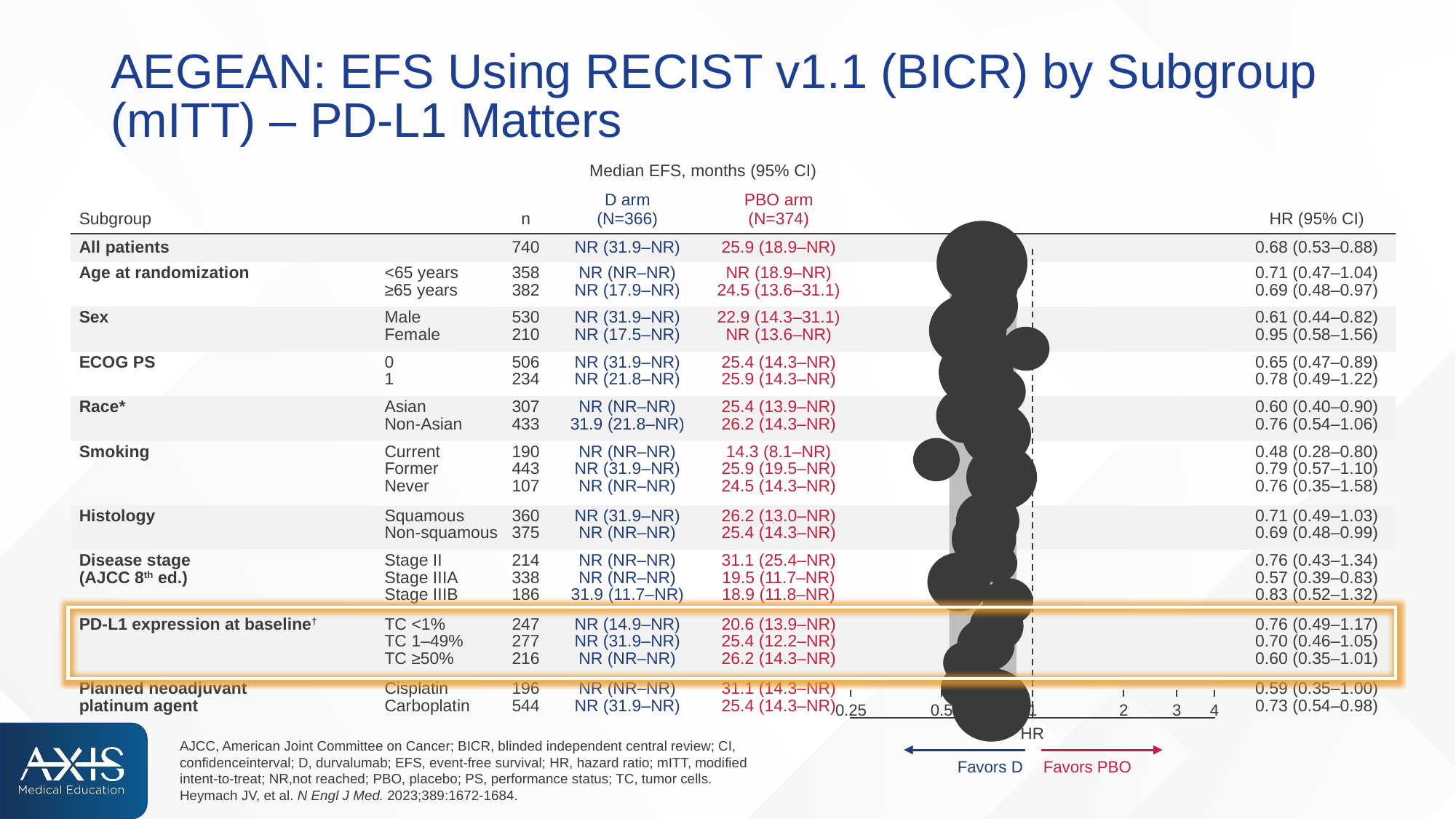
Which subgroup has the lowest point-estimate hazard ratio? Current (smoking) Which has the larger HR point estimate, Stage IIIA or Stage IIIB? Stage IIIB What is the difference between the HR point estimates for Female and Current smokers? 0.47 How many subgroup rows (including All patients) are plotted in the forest plot? 22 What is the HR (95% CI) for the Current smoking subgroup? 0.48 (0.28–0.80) Which arm does the left side of the forest plot (HR below 1) favor? Favors D What is the HR (95% CI) for the PD-L1 TC ≥50% subgroup? 0.60 (0.35–1.01) What is the label of the x axis of the forest plot? HR What is the hazard ratio (95% CI) for All patients in the forest plot? 0.68 (0.53–0.88) What kind of chart is shown on the slide? Forest plot Is the HR point estimate for the Male subgroup greater or less than 1? less Which subgroup has the highest point-estimate hazard ratio? Female